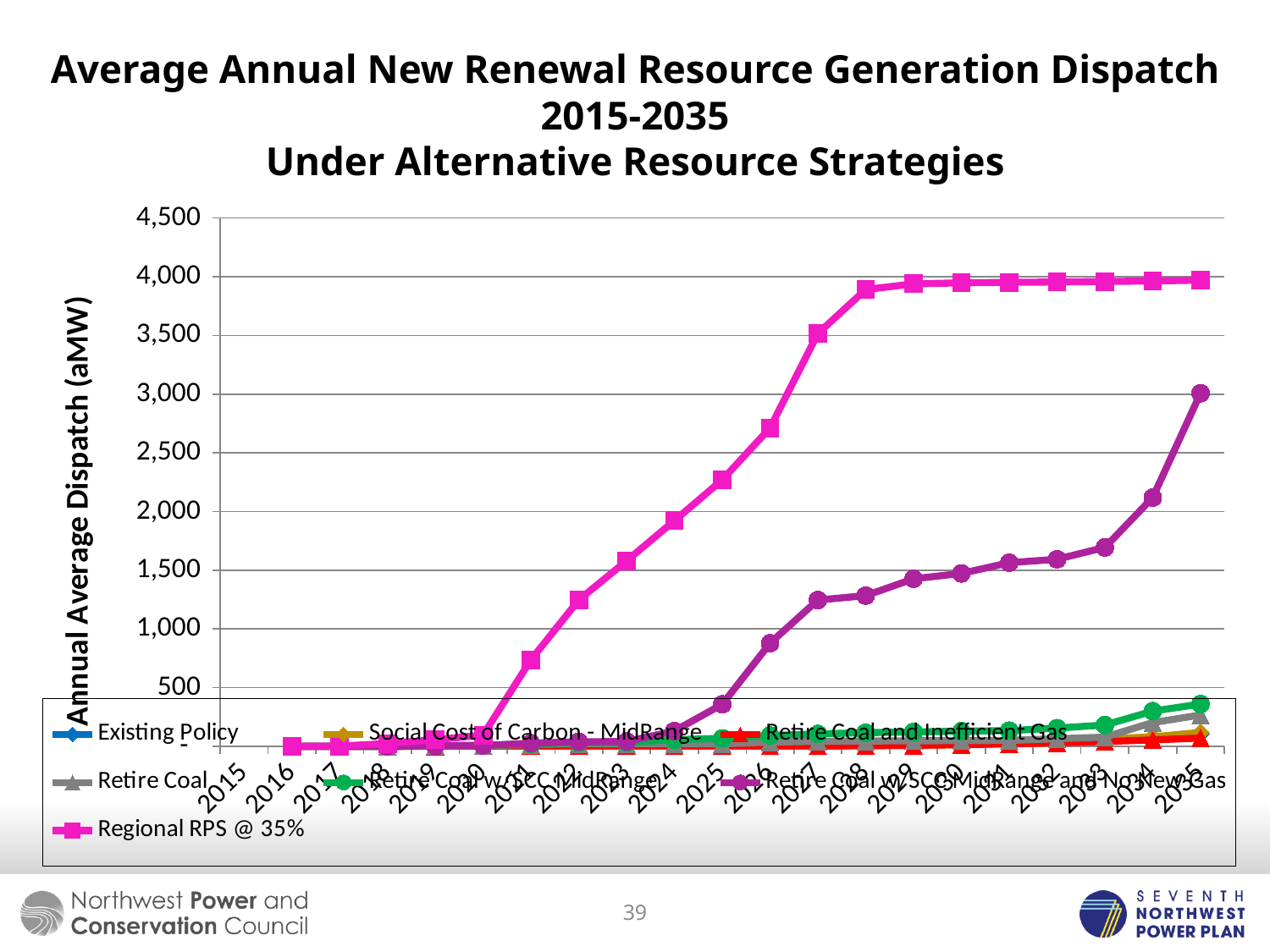
How many years are plotted along the x axis? 21 Which series has the highest value in 2035? Regional RPS @ 35% Is the value for Retire Coal w/SCC MidRange and No New Gas in 2027 greater or less than 1,000? greater Is the value for Regional RPS @ 35% in 2035 greater or less than 3,500? greater How many series does the legend list? 7 Is the value for Regional RPS @ 35% in 2025 greater or less than 2,000? greater What kind of chart is shown on the slide? line chart What is the label on the y axis? Annual Average Dispatch (aMW) Does the Regional RPS @ 35% series rise or fall from 2015 to 2035? rise In 2030, which is larger: Regional RPS @ 35% or Retire Coal w/SCC MidRange and No New Gas? Regional RPS @ 35%